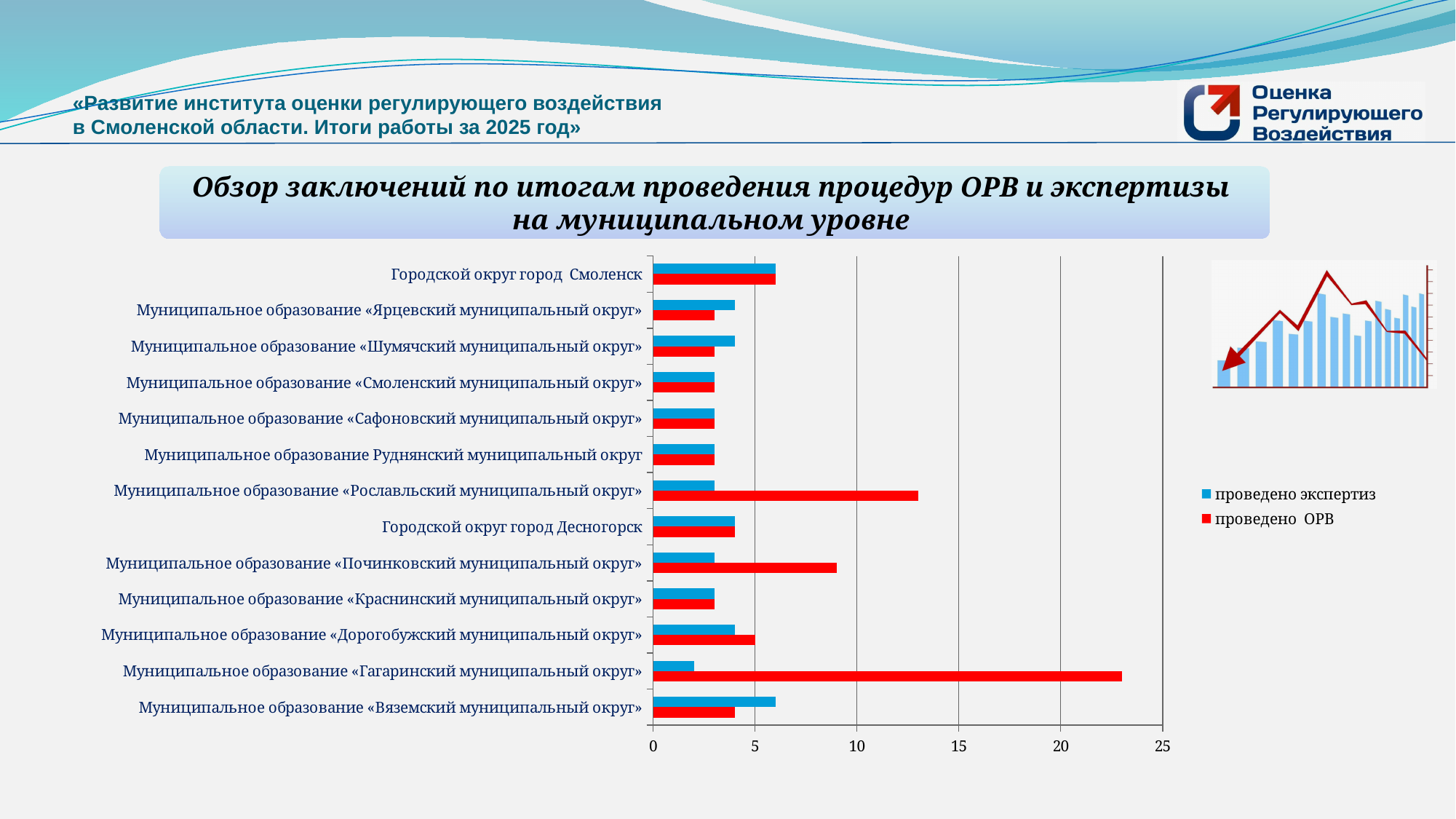
Is the «проведено экспертиз» value for Городской округ город Смоленск greater or less than 5? greater Which is larger for Муниципальное образование «Починковский муниципальный округ»: «проведено экспертиз» or «проведено ОРВ»? проведено ОРВ What colour represents the «проведено ОРВ» series in the legend? red Is the «проведено ОРВ» value for Муниципальное образование «Рославльский муниципальный округ» greater or less than 10? greater How many municipalities (categories) are shown on the chart? 13 How many series does the chart legend list? 2 Which municipality has the highest value for «проведено ОРВ»? Муниципальное образование «Гагаринский муниципальный округ» Is the «проведено ОРВ» value for Муниципальное образование «Починковский муниципальный округ» greater or less than 10? less Which municipality has the lowest value for «проведено экспертиз»? Муниципальное образование «Гагаринский муниципальный округ» Which is larger: the «проведено ОРВ» value for Муниципальное образование «Гагаринский муниципальный округ» or for Муниципальное образование «Рославльский муниципальный округ»? Муниципальное образование «Гагаринский муниципальный округ» What kind of chart is shown on the slide? bar chart